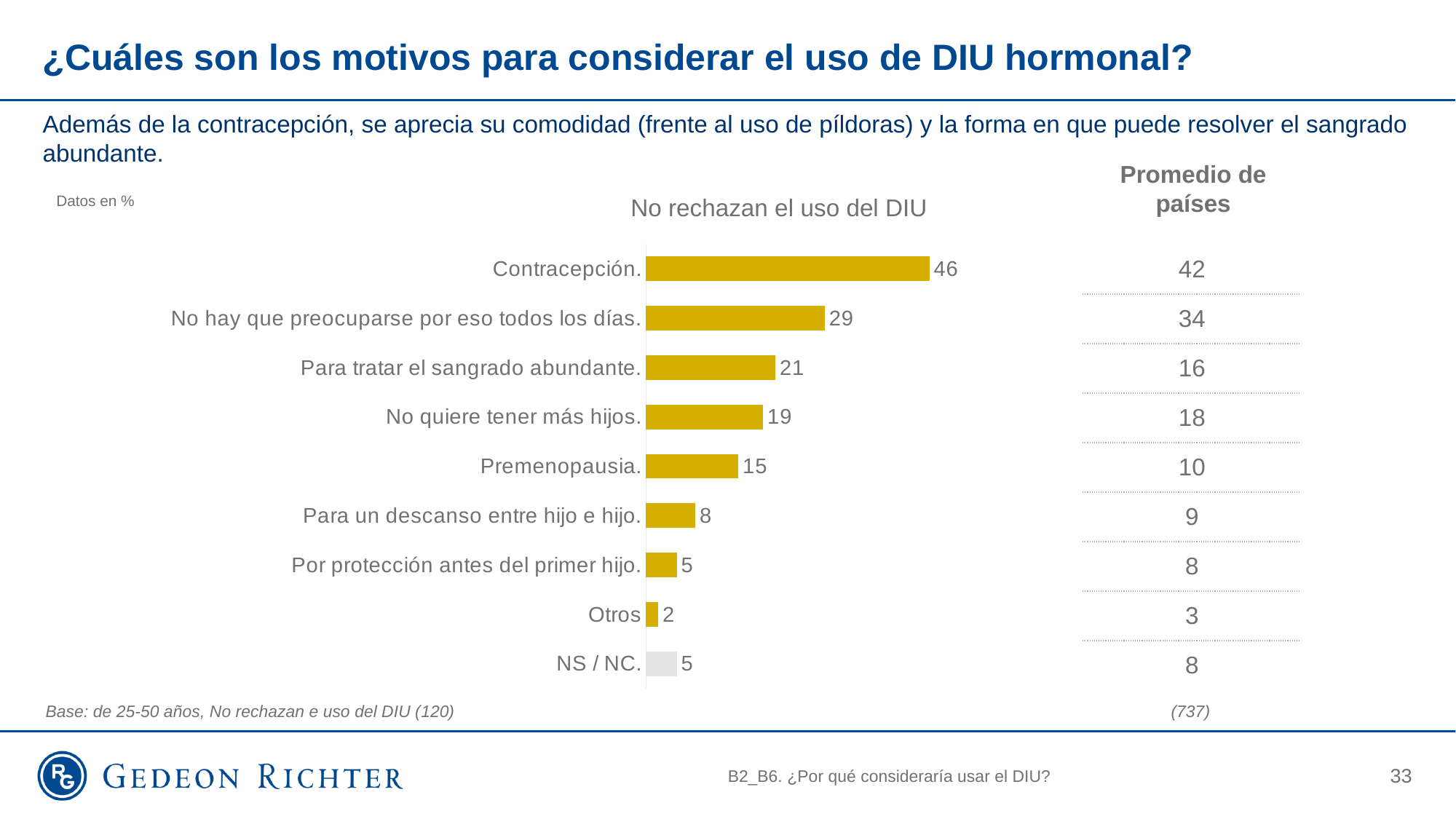
What colour are the bars for the named reasons in the chart? Yellow What is the value for "Contracepción." in the "No rechazan el uso del DIU" chart? 46 What is the value for "Para un descanso entre hijo e hijo." in the chart? 8 What is the value for "Premenopausia." in the chart? 15 Which category has the lowest value in the chart? Otros What kind of chart is shown on the slide? Bar chart What is the difference between the values for "Contracepción." and "No hay que preocuparse por eso todos los días."? 17 How many categories are shown in the chart? 9 Which category has the highest value in the chart? Contracepción. What is the title of the chart? No rechazan el uso del DIU What is the value for "Para tratar el sangrado abundante." in the chart? 21 Which is larger: the value for "No quiere tener más hijos." or the value for "Premenopausia."? No quiere tener más hijos.